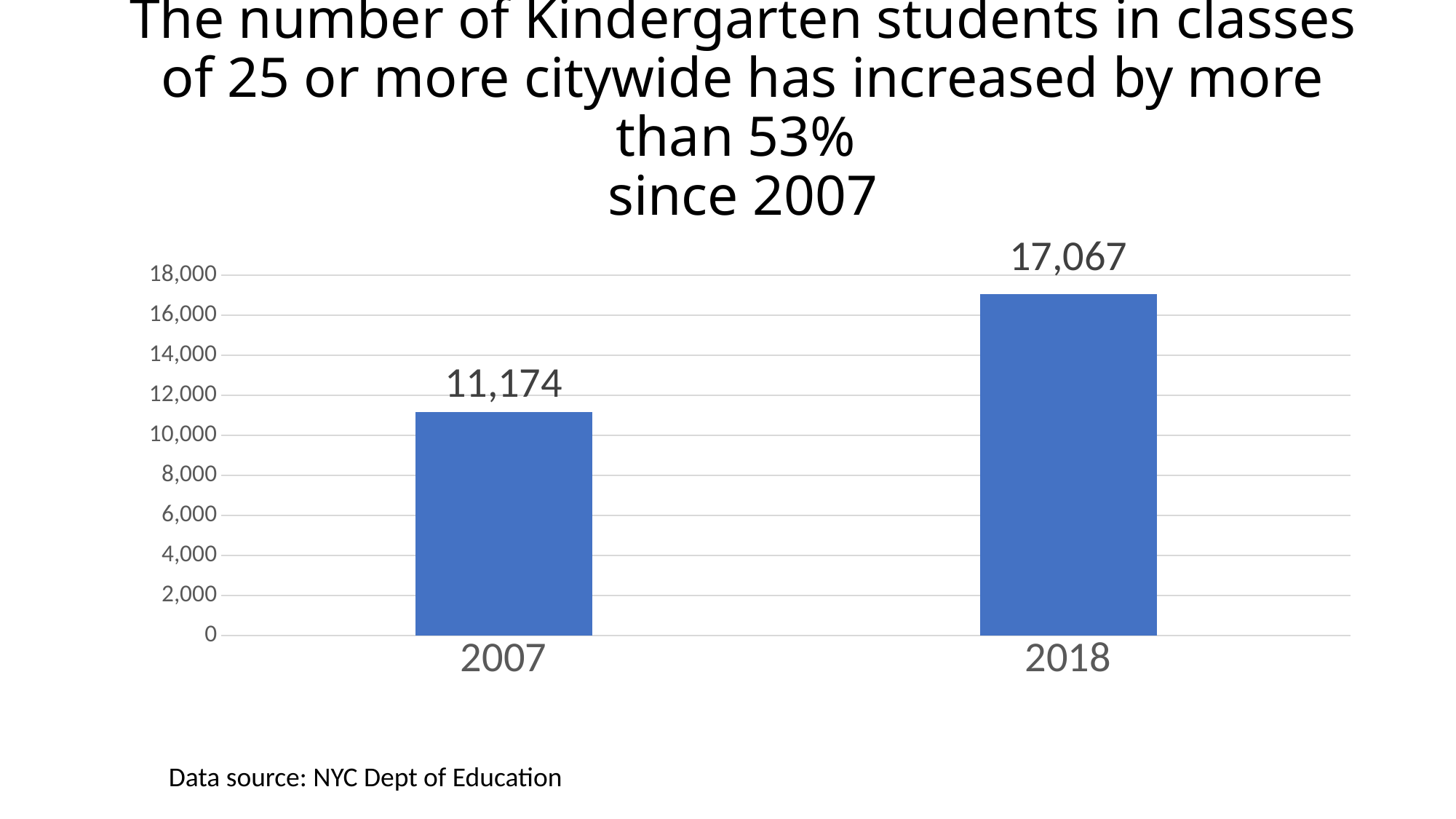
Which year has the highest value? 2018 What is the value for 2007? 11,174 Which year has the lowest value? 2007 What is the value for 2018? 17,067 What data source is cited on the slide? NYC Dept of Education Do the values rise or fall from 2007 to 2018? rise Which is larger, the value for 2007 or the value for 2018? 2018 Is the value for 2007 greater or less than 12,000? less How many bars are shown in the chart? 2 What is the difference between the values for 2018 and 2007? 5,893 Is the value for 2018 greater or less than 16,000? greater What kind of chart is shown on the slide? bar chart